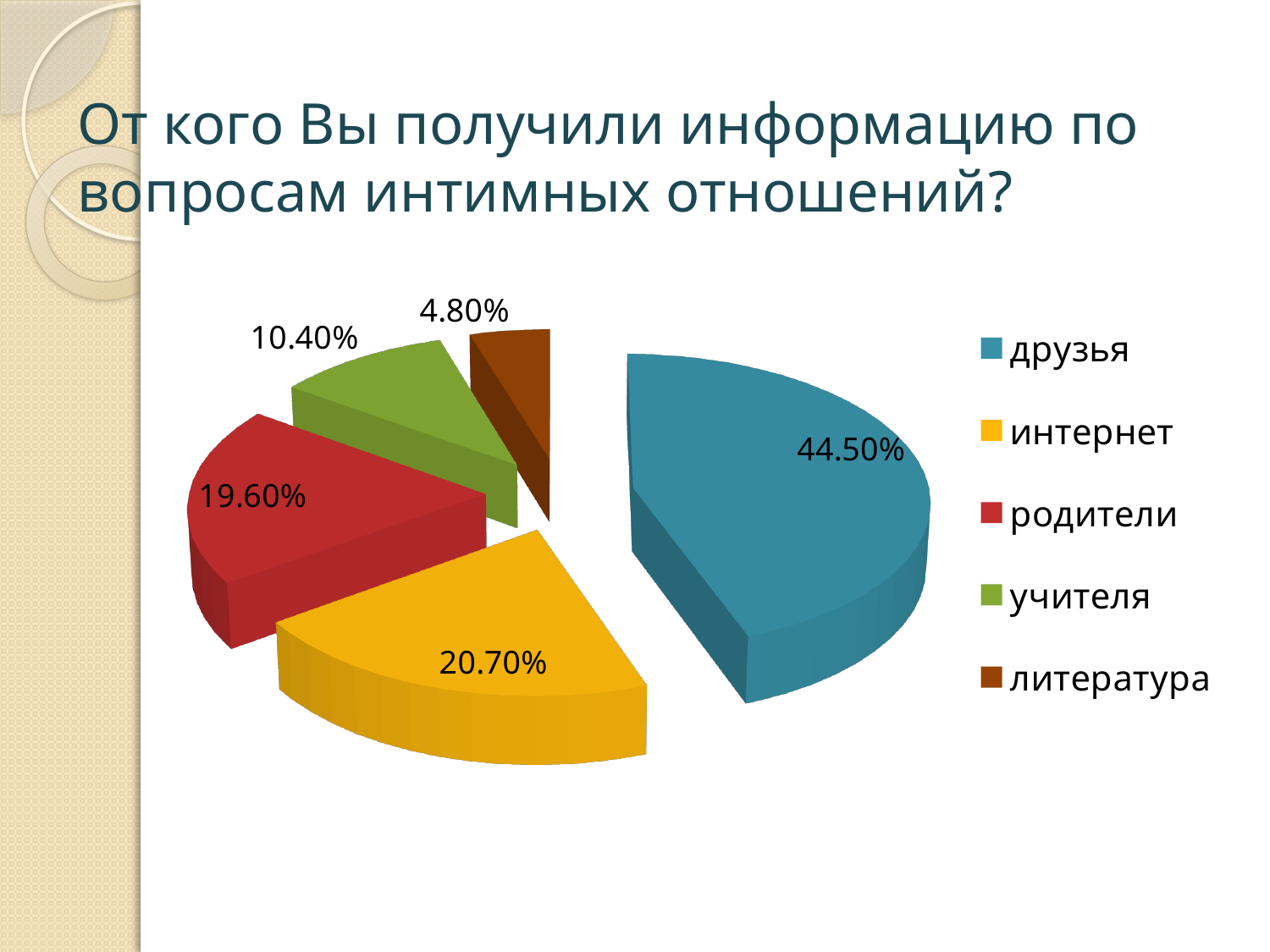
Which category has the smallest slice of the pie? литература What share of the pie does учителя have? 10.40% What share of the pie does литература have? 4.80% What share of the pie does друзья have? 44.50% What kind of chart is shown on the slide? pie chart How many categories does the pie chart show? 5 Which category has the largest slice of the pie? друзья Which colour represents родители in the legend? red Which is larger, the share for учителя or the share for литература? учителя What share of the pie does родители have? 19.60% What is the difference between the shares for друзья and интернет? 23.80% What share of the pie does интернет have? 20.70%